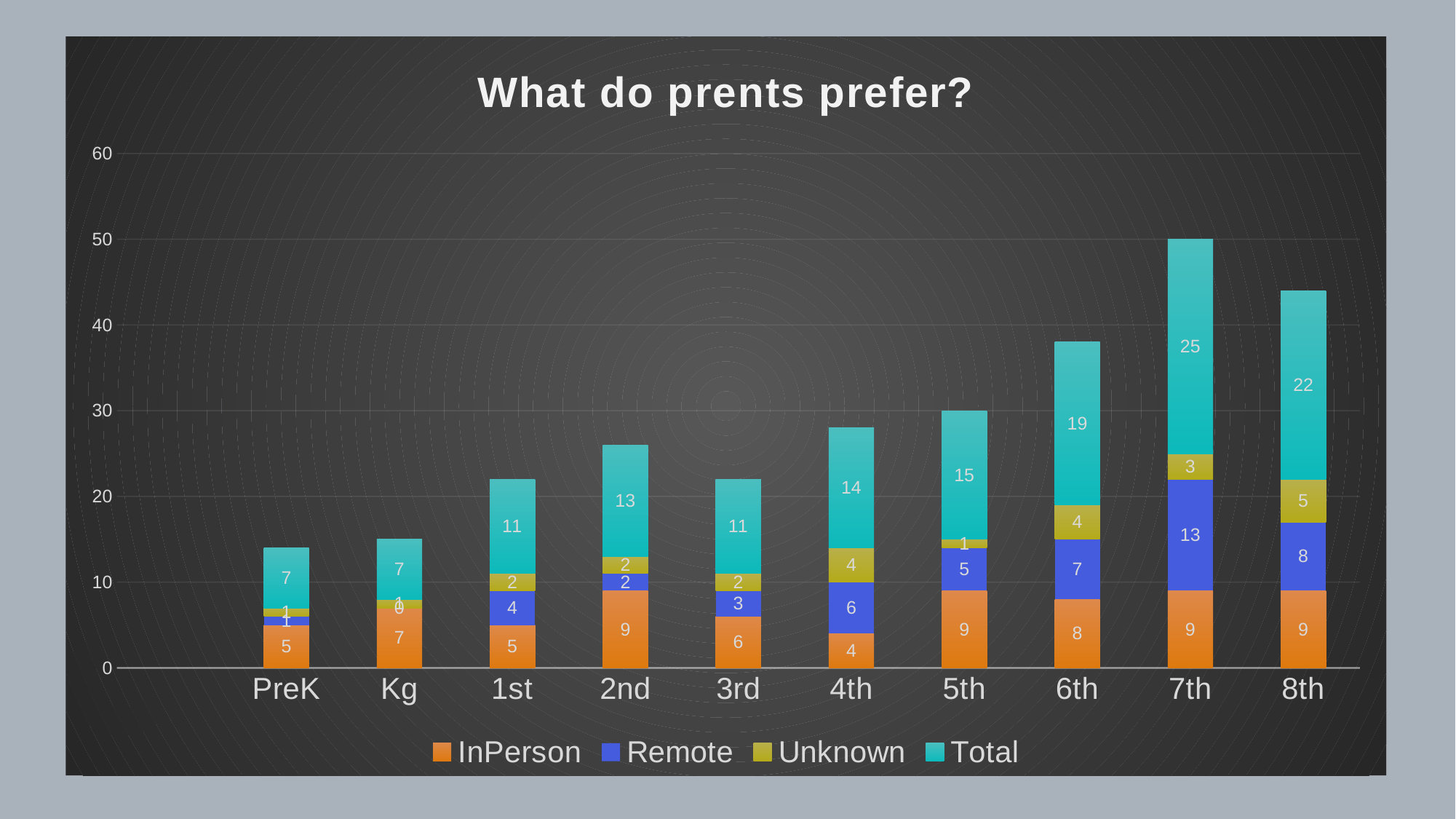
What is the Total value for 6th grade? 19 What is the InPerson value for 7th grade? 9 Which grade has the highest Total value? 7th What kind of chart is shown on the slide? Stacked bar chart How many grade categories are shown on the x axis? 10 Which grade has the lowest InPerson value? 4th Which is larger, the Total value for 2nd grade or for 3rd grade? 2nd What is the difference between the Remote values for 7th and 8th grade? 5 What is the combined height of the stacked bar for 5th grade? 30 How many series does the legend list? 4 What is the Remote value for 4th grade? 6 What is the Unknown value for 8th grade? 5